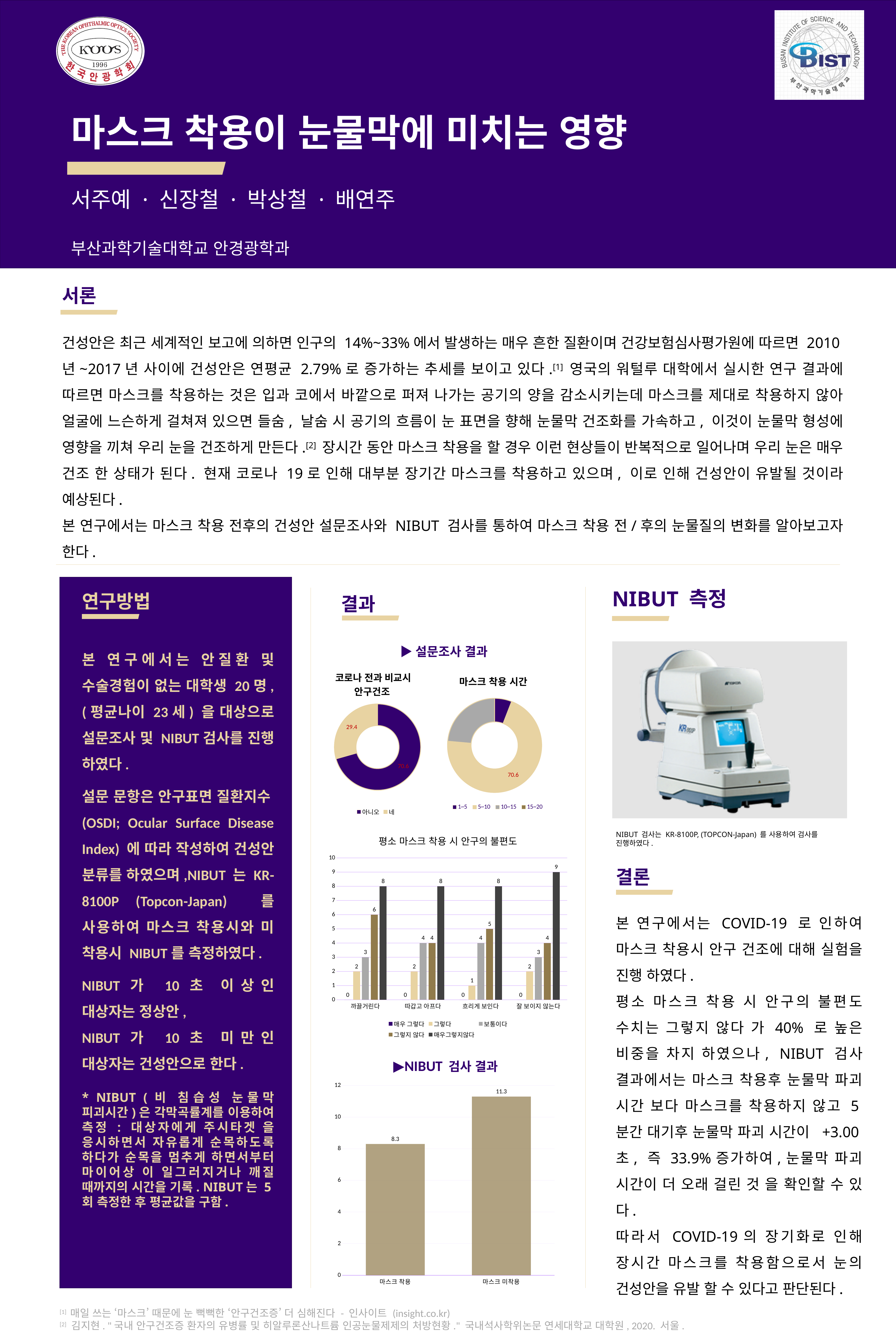
In the 평소 마스크 착용 시 안구의 불편도 chart, what is the value of 그렇지 않다 for 까끌거린다? 6 In the NIBUT 검사 결과 chart, what is the difference between 마스크 미착용 and 마스크 착용? 3.0 What kind of chart is the NIBUT 검사 결과 chart? bar chart In the 코로나 전과 비교시 안구건조 donut chart, what is the value for 아니오? 70.6 In the NIBUT 검사 결과 chart, what is the value for 마스크 미착용? 11.3 In the NIBUT 검사 결과 chart, what is the value for 마스크 착용? 8.3 In the 코로나 전과 비교시 안구건조 donut chart, what is the value for 네? 29.4 How many series does the legend of the 평소 마스크 착용 시 안구의 불편도 chart list? 5 In the 평소 마스크 착용 시 안구의 불편도 chart, what is the value of 매우그렇지않다 for 잘 보이지 않는다? 9 In the 평소 마스크 착용 시 안구의 불편도 chart, what is the value of 그렇다 for 흐리게 보인다? 1 How many categories are shown on the x axis of the 평소 마스크 착용 시 안구의 불편도 chart? 4 In the NIBUT 검사 결과 chart, which category has the higher value, 마스크 착용 or 마스크 미착용? 마스크 미착용